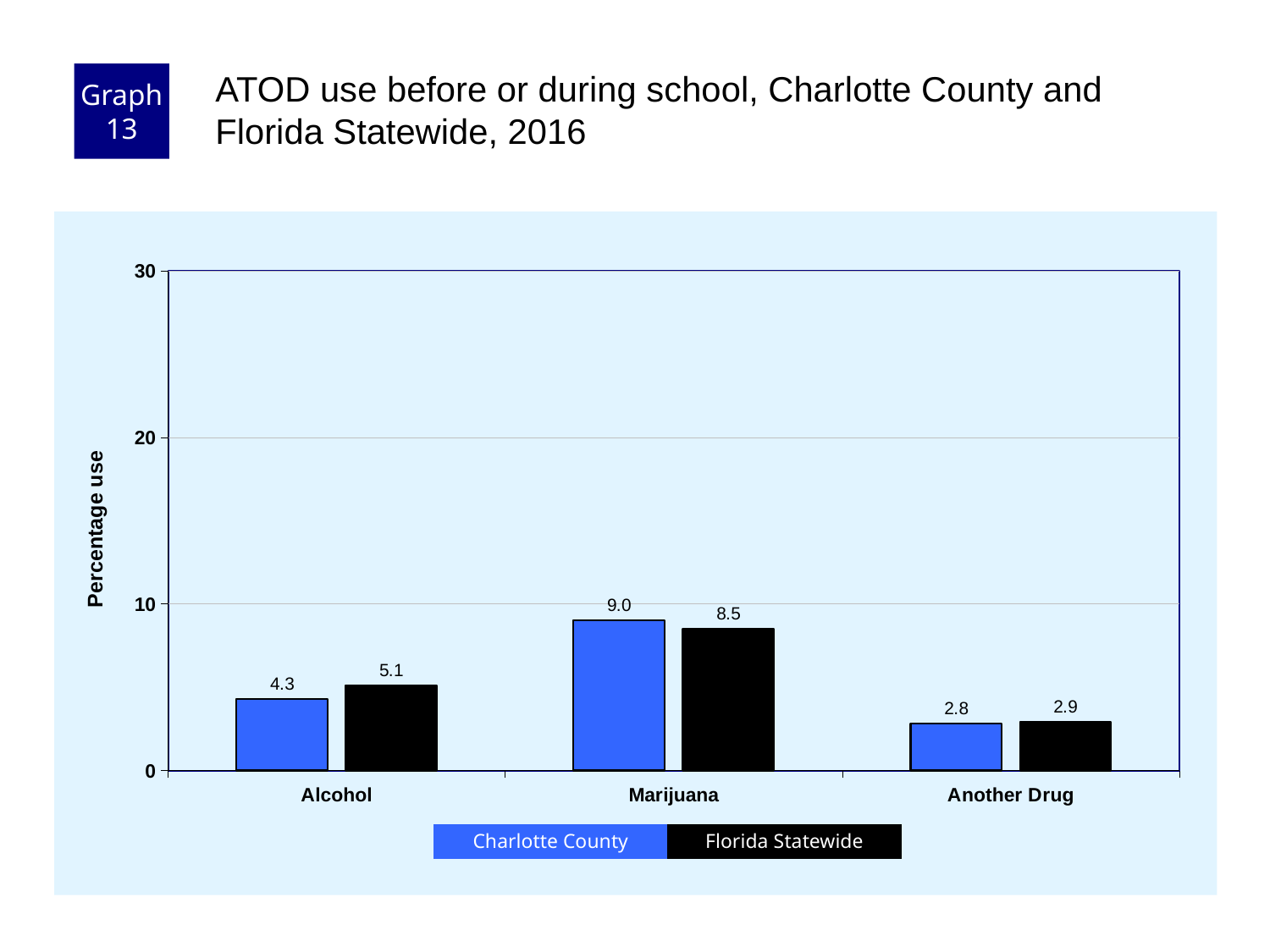
Which category has the highest Charlotte County value? Marijuana What kind of chart is shown on the slide? bar chart What is the Florida Statewide value for Alcohol? 5.1 Is the Florida Statewide value for Marijuana greater or less than 10? less What is the Charlotte County value for Marijuana? 9.0 What is the difference between the Charlotte County and Florida Statewide values for Alcohol? 0.8 How many series does the legend list? 2 Which category has the lowest Florida Statewide value? Another Drug How many categories are shown on the x axis? 3 For Alcohol, which is larger: Charlotte County or Florida Statewide? Florida Statewide What is the Charlotte County value for Another Drug? 2.8 What is the difference between the Charlotte County and Florida Statewide values for Marijuana? 0.5